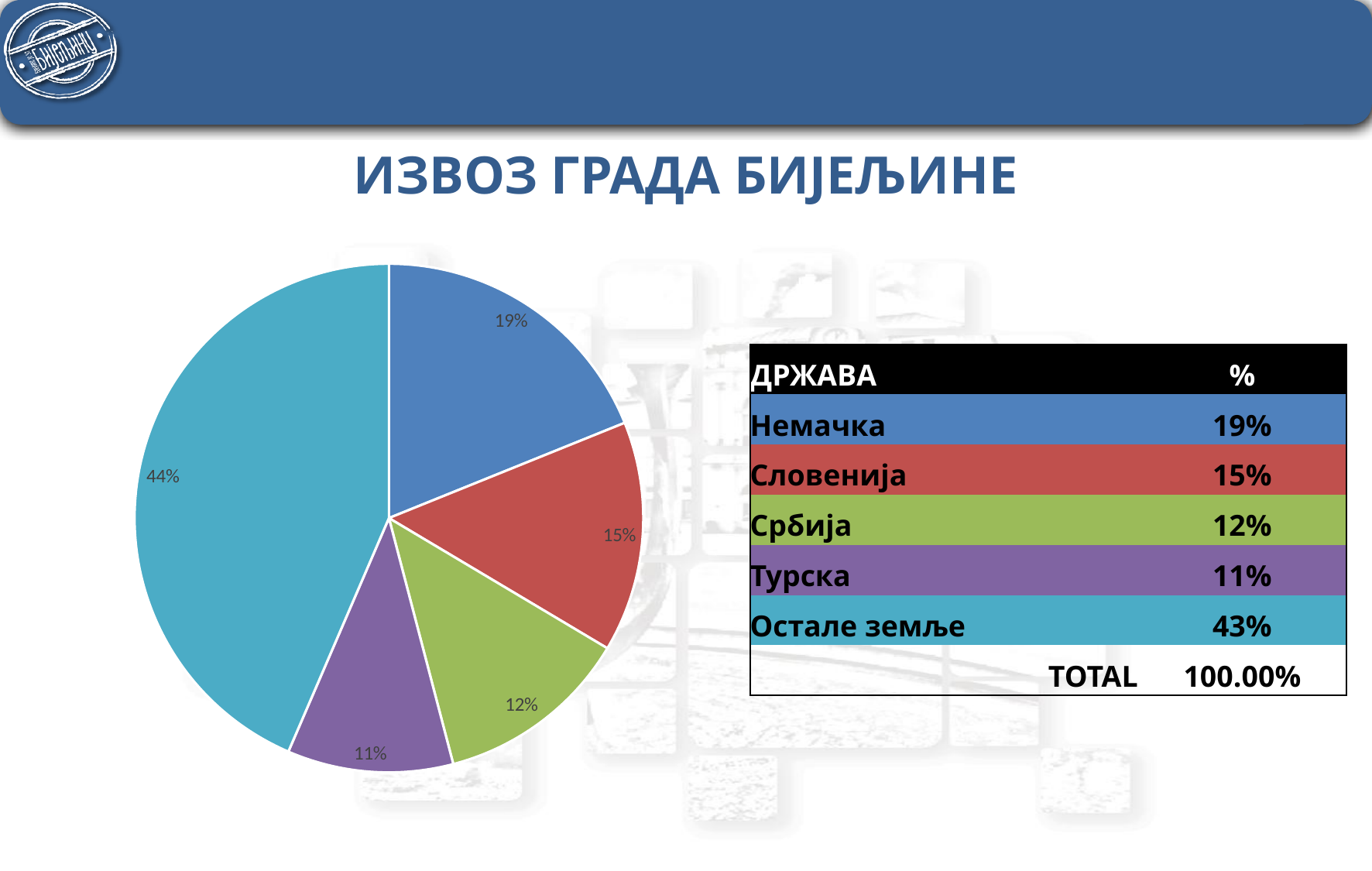
What percentage of exports goes to Немачка according to the pie chart? 19% What colour is the slice for Немачка? blue What percentage label is printed on the largest slice of the pie chart? 44% What percentage is shown for Словенија? 15% What percentage is shown for Турска? 11% What is the difference in percentage points between Немачка and Словенија? 4% Which named country has the smallest slice of the pie chart? Турска How many slices does the pie chart have? 5 Which has a larger share, Србија or Турска? Србија Which category has the largest slice of the pie chart? Остале земље What percentage is shown for Србија? 12% What kind of chart is shown on the slide? pie chart